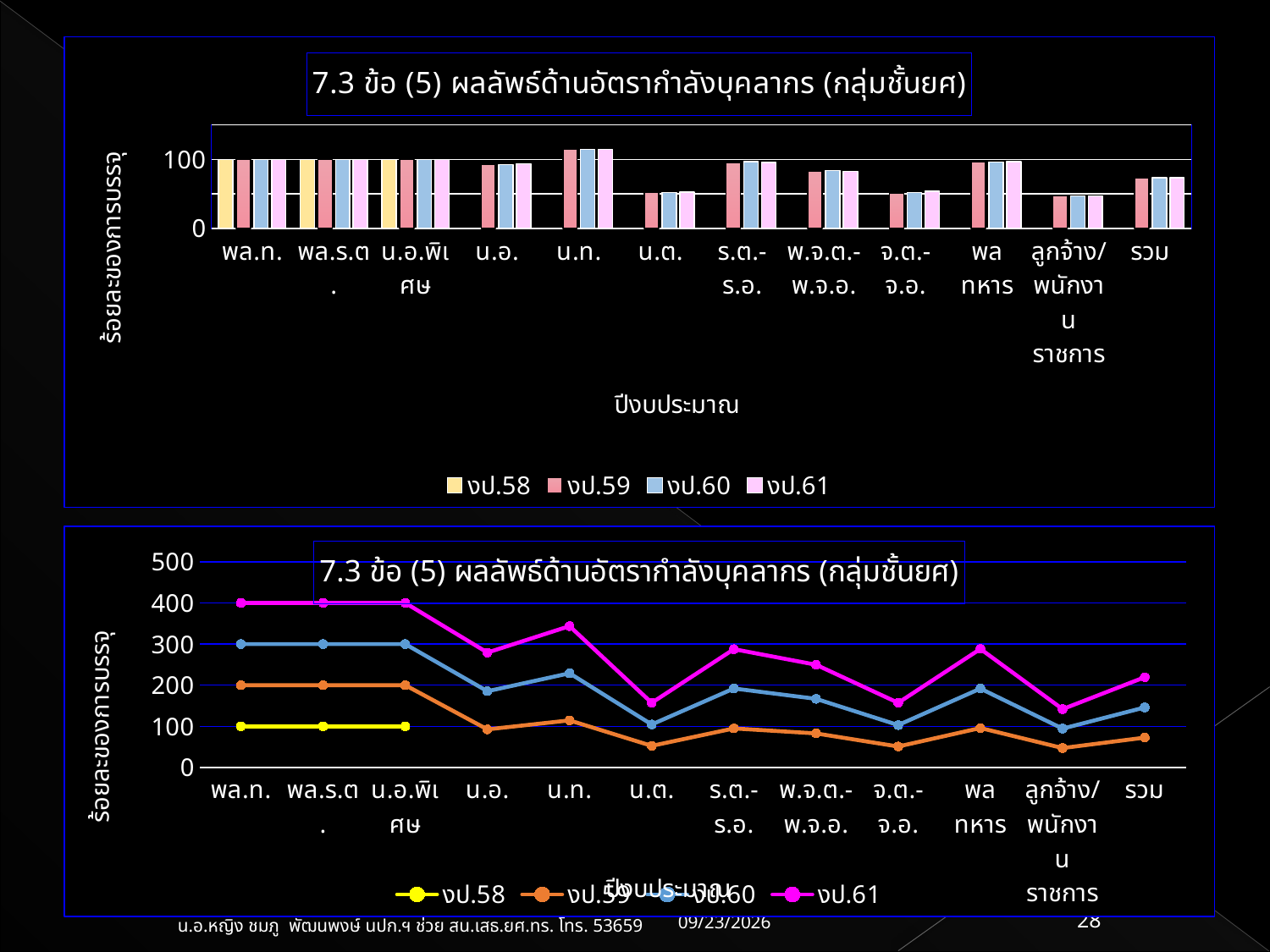
In the bottom line chart, how many series does the legend list? 4 In the bottom line chart, which is larger for งป.61: น.ท. or น.ต.? น.ท. What kind of chart is the top chart on the slide? bar chart In the top bar chart, how many categories are shown on the x axis? 12 In the bottom line chart, does the งป.61 line rise or fall from น.อ.พิเศษ to น.อ.? fall In the top bar chart, is the value of งป.59 for น.ต. greater or less than 100? less In the bottom line chart, what is the value of งป.58 for พล.ท.? 100 What kind of chart is the bottom chart on the slide? line chart